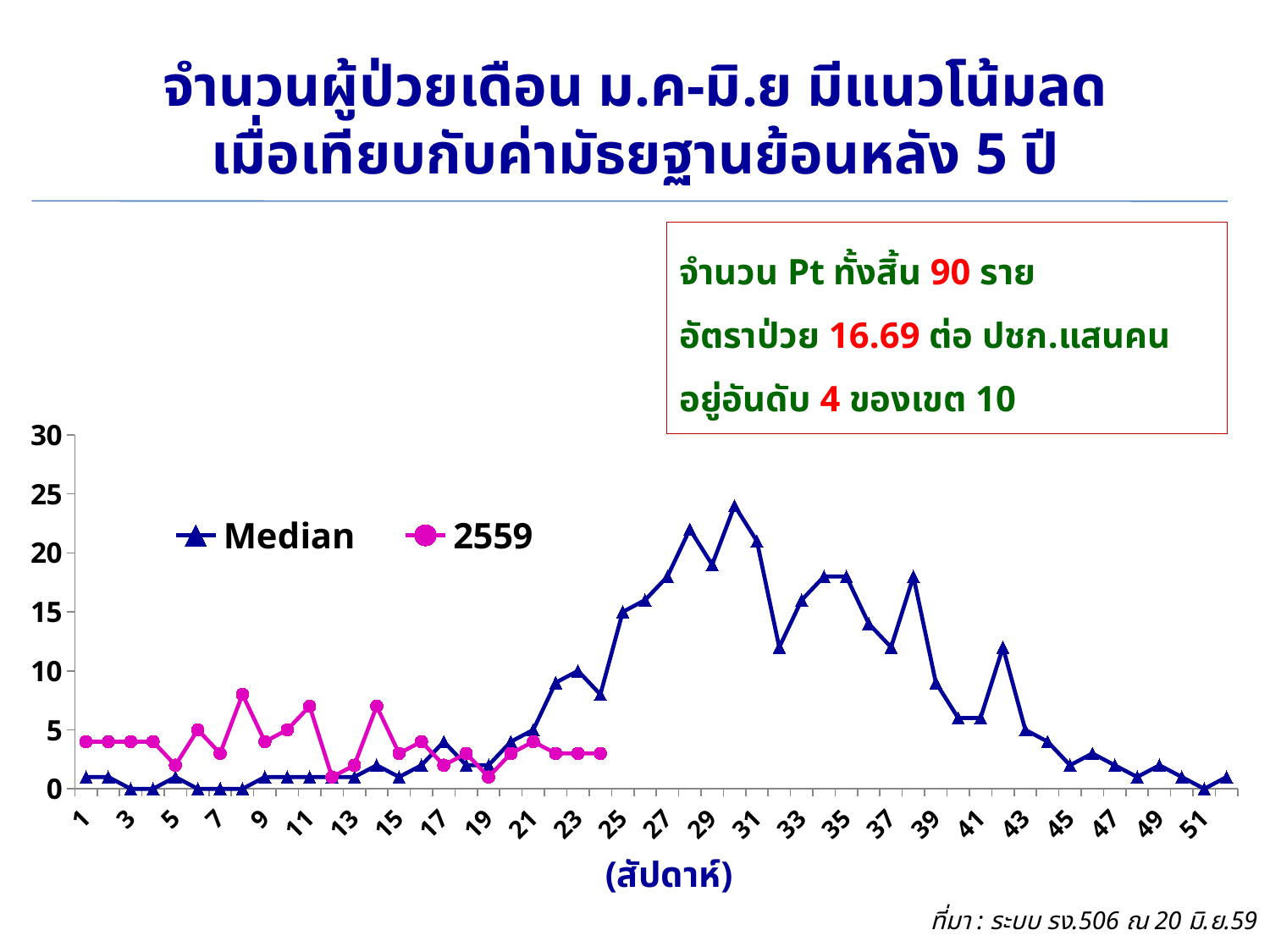
Is the 2559 value at week 8 greater or less than 5? greater How many series does the legend list? 2 Is the Median value at week 43 greater or less than 10? less For the Median series, which is larger: the value at week 30 or the value at week 10? week 30 What are the two series named in the legend? Median and 2559 What is the label shown under the x axis? (สัปดาห์) What kind of chart is shown on the slide? line chart Is the 2559 value at week 14 greater or less than 5? greater At which week does the Median series reach its highest value? 30 At week 8, which series has the higher value, Median or 2559? 2559 From week 30 to week 52, does the Median series generally rise or fall? fall